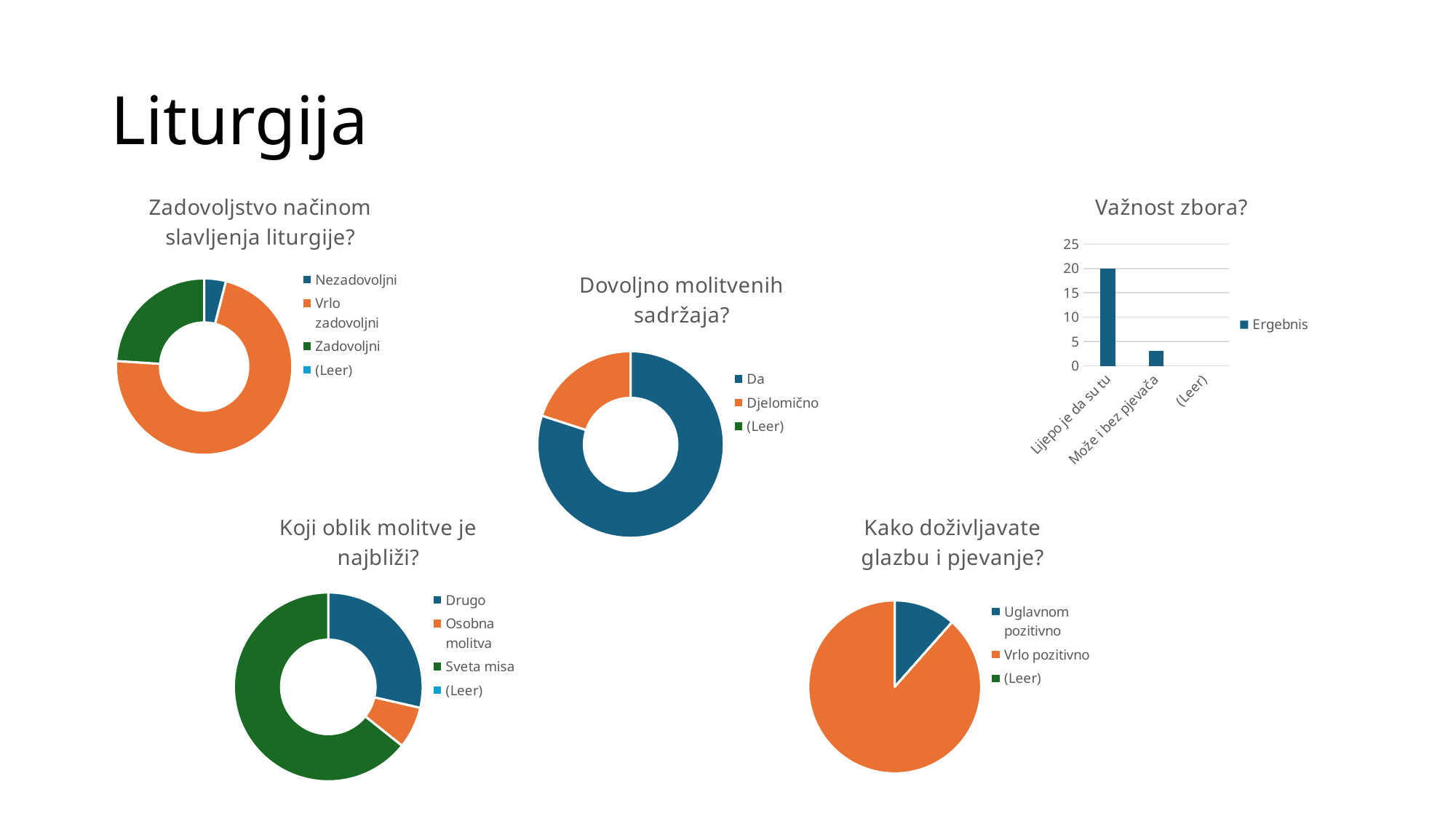
In the 'Koji oblik molitve je najbliži?' chart, which is larger: 'Drugo' or 'Osobna molitva'? Drugo In the 'Važnost zbora?' chart, which category has the highest value? Lijepo je da su tu In the 'Koji oblik molitve je najbliži?' chart, which category has the largest share? Sveta misa What is the name of the series in the legend of the 'Važnost zbora?' chart? Ergebnis In the 'Dovoljno molitvenih sadržaja?' chart, which category has the largest share? Da In the 'Važnost zbora?' chart, is the value for 'Može i bez pjevača' greater or less than 5? less In the 'Važnost zbora?' chart, what is the value for 'Lijepo je da su tu'? 20 How many series does the legend of the 'Važnost zbora?' chart list? 1 How many categories are shown on the x axis of the 'Važnost zbora?' chart? 3 What kind of chart is 'Važnost zbora?'? bar chart